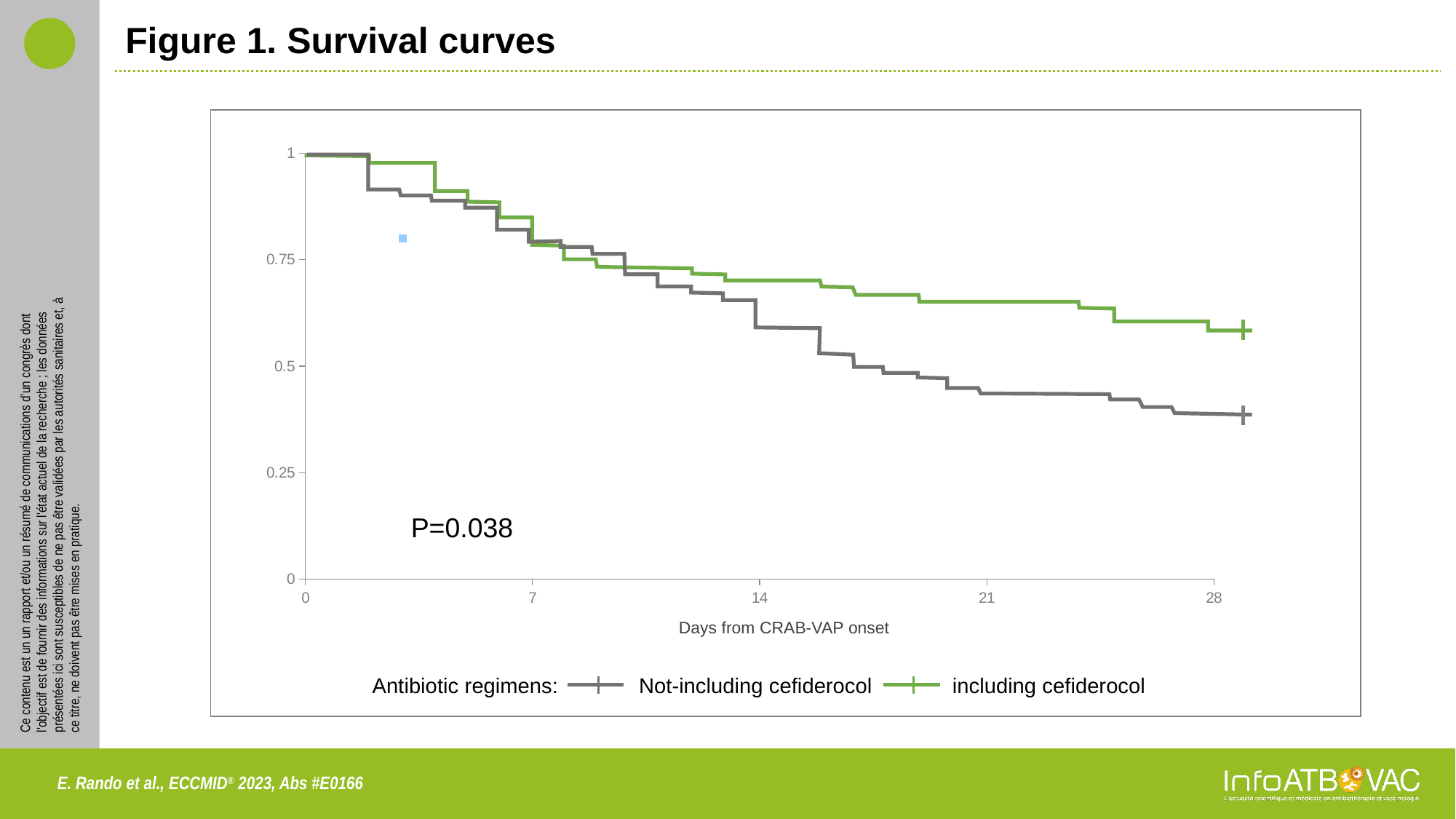
At day 28, which series has the higher survival probability, Not-including cefiderocol or including cefiderocol? including cefiderocol What is the title of the figure? Figure 1. Survival curves How many series does the legend list? 2 What kind of chart is shown on the slide? line chart What P value is printed on the chart? P=0.038 Do the survival curves rise or fall as days from CRAB-VAP onset increase? fall Is the value for including cefiderocol at day 28 greater or less than 0.5? greater Is the value for Not-including cefiderocol at day 28 greater or less than 0.5? less What is the label of the x axis? Days from CRAB-VAP onset Which series is drawn in green? including cefiderocol Is the value for including cefiderocol at day 21 greater or less than 0.75? less What is the survival probability of both curves at day 0? 1